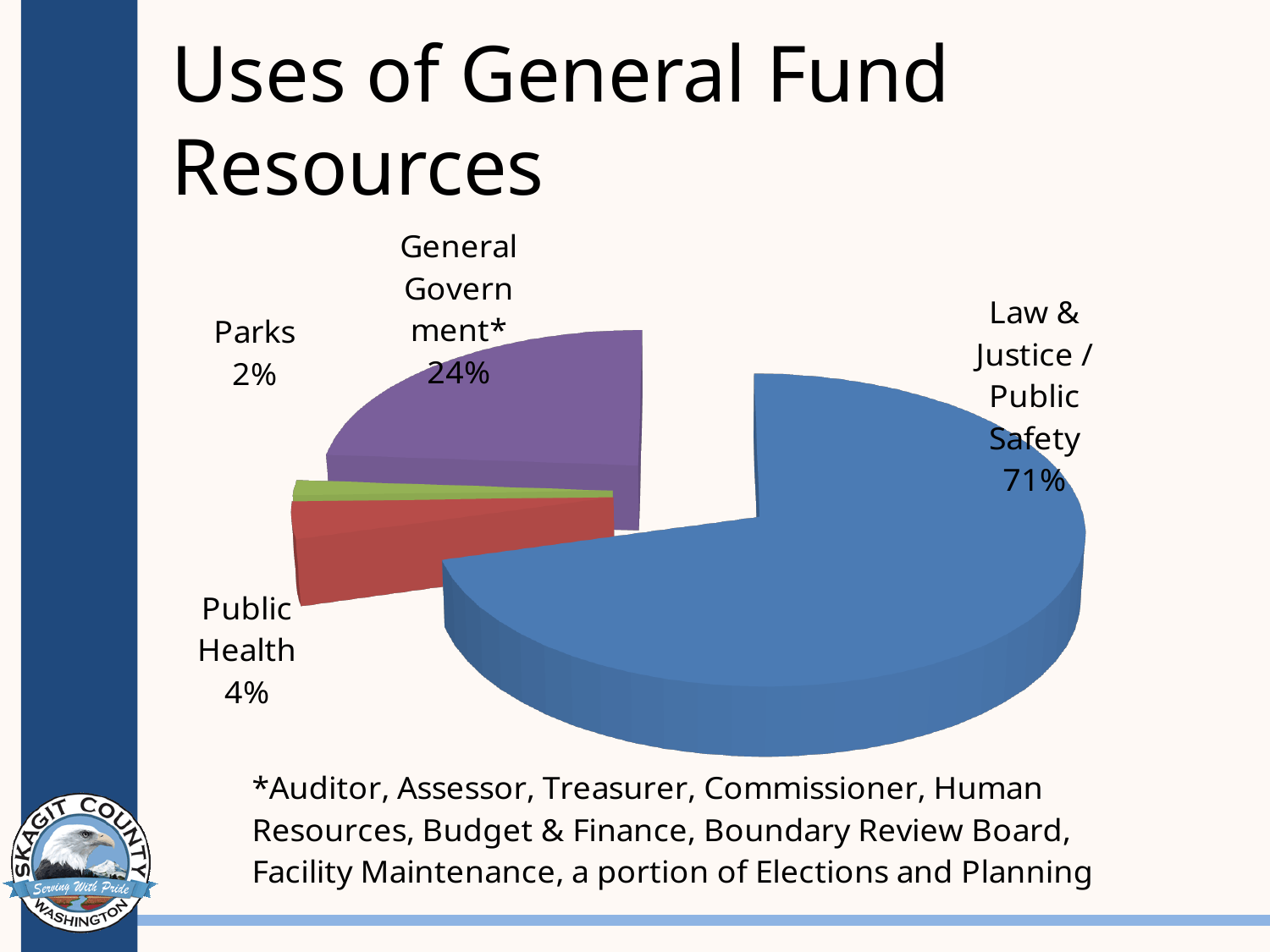
How many categories are shown in the pie chart? 4 What kind of chart is shown on the slide? Pie chart What share of General Fund resources goes to Parks? 2% What share of General Fund resources goes to Law & Justice / Public Safety? 71% Which is larger, the share for Public Health or the share for Parks? Public Health What colour is the Law & Justice / Public Safety slice? Blue What share of General Fund resources goes to General Government*? 24% What share of General Fund resources goes to Public Health? 4% What is the title of the slide containing the chart? Uses of General Fund Resources Which category has the smallest share of the pie? Parks Which category has the largest share of the pie? Law & Justice / Public Safety What is the difference in percentage points between Law & Justice / Public Safety and General Government*? 47